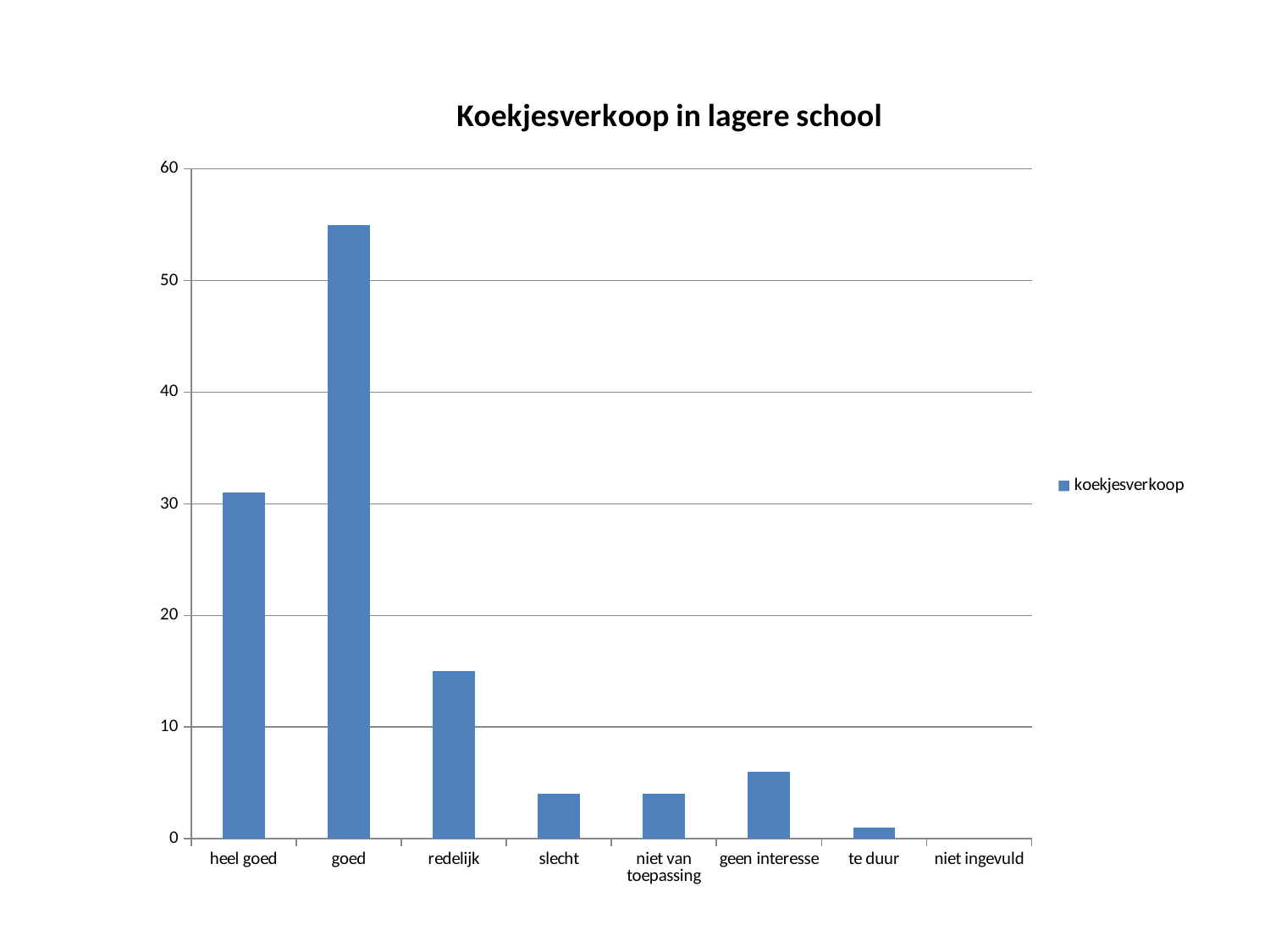
Is the value for goed greater or less than 50? greater Is the value for geen interesse greater or less than 10? less What kind of chart is shown on the slide? bar chart Which category has the highest value? goed Is the value for heel goed greater or less than 40? less Which is larger, the value for heel goed or the value for redelijk? heel goed How many categories are shown on the x axis? 8 Which category has the lowest value? niet ingevuld What is the name of the series shown in the legend? koekjesverkoop How many series does the legend list? 1 What is the title of the chart? Koekjesverkoop in lagere school